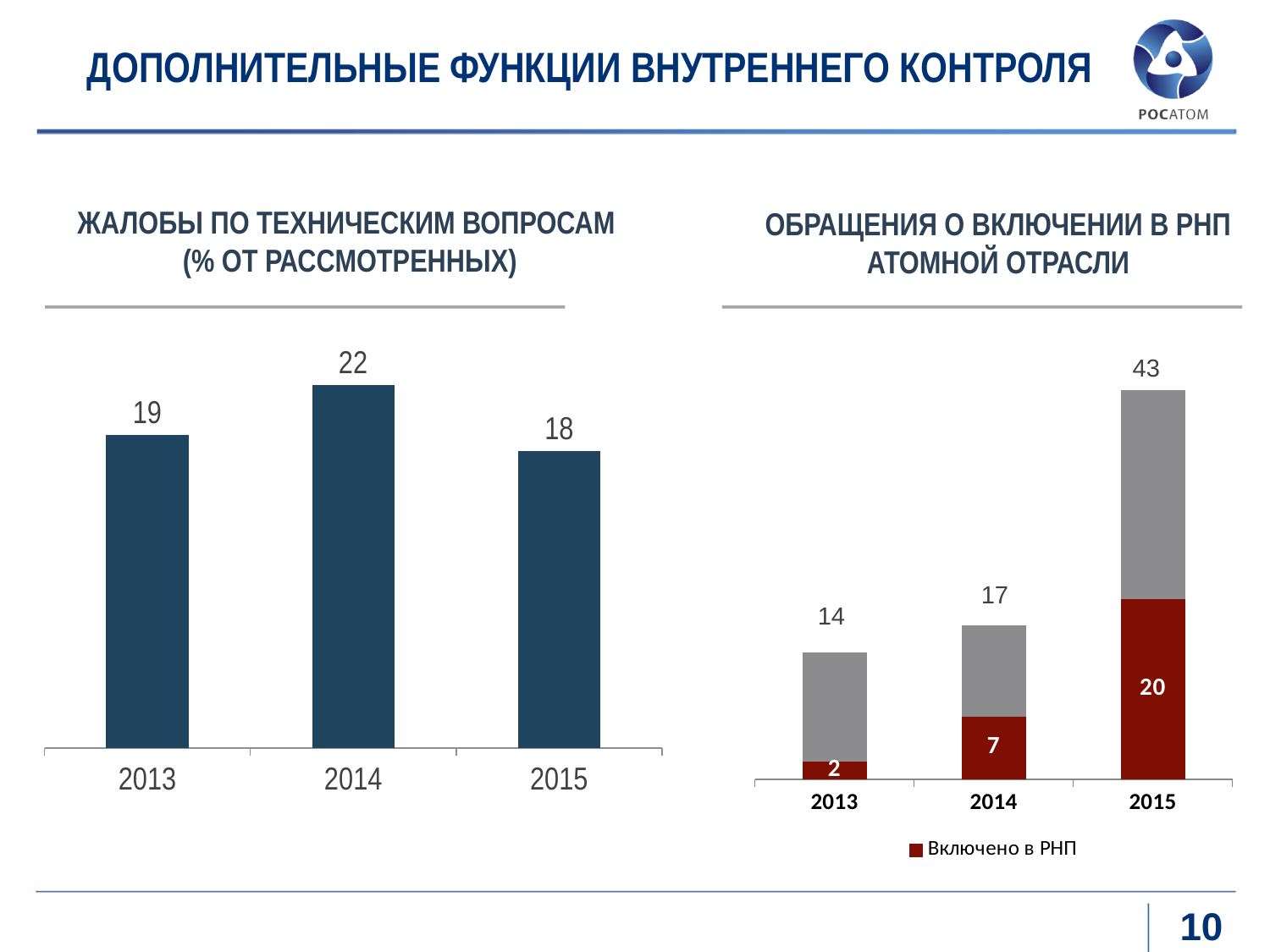
In the left chart (ЖАЛОБЫ ПО ТЕХНИЧЕСКИМ ВОПРОСАМ), how many years are shown? 3 In the left chart (ЖАЛОБЫ ПО ТЕХНИЧЕСКИМ ВОПРОСАМ), which year has the highest value? 2014 In the right chart (ОБРАЩЕНИЯ О ВКЛЮЧЕНИИ В РНП АТОМНОЙ ОТРАСЛИ), which is larger: the 'Включено в РНП' value for 2013 or for 2015? 2015 In the left chart (ЖАЛОБЫ ПО ТЕХНИЧЕСКИМ ВОПРОСАМ), what is the value for 2014? 22 In the right chart (ОБРАЩЕНИЯ О ВКЛЮЧЕНИИ В РНП АТОМНОЙ ОТРАСЛИ), what entry does the legend list? Включено в РНП In the right chart (ОБРАЩЕНИЯ О ВКЛЮЧЕНИИ В РНП АТОМНОЙ ОТРАСЛИ), what is the total value of the bar for 2015? 43 What kind of chart is the left chart (ЖАЛОБЫ ПО ТЕХНИЧЕСКИМ ВОПРОСАМ)? Bar chart In the left chart (ЖАЛОБЫ ПО ТЕХНИЧЕСКИМ ВОПРОСАМ), which year has the lowest value? 2015 In the right chart (ОБРАЩЕНИЯ О ВКЛЮЧЕНИИ В РНП АТОМНОЙ ОТРАСЛИ), do the bar totals rise or fall from 2013 to 2015? Rise In the right chart (ОБРАЩЕНИЯ О ВКЛЮЧЕНИИ В РНП АТОМНОЙ ОТРАСЛИ), what is the difference between the total for 2015 and the total for 2014? 26 In the left chart (ЖАЛОБЫ ПО ТЕХНИЧЕСКИМ ВОПРОСАМ), what is the difference between the 2014 and 2015 values? 4 In the right chart (ОБРАЩЕНИЯ О ВКЛЮЧЕНИИ В РНП АТОМНОЙ ОТРАСЛИ), what is the value of 'Включено в РНП' for 2014? 7